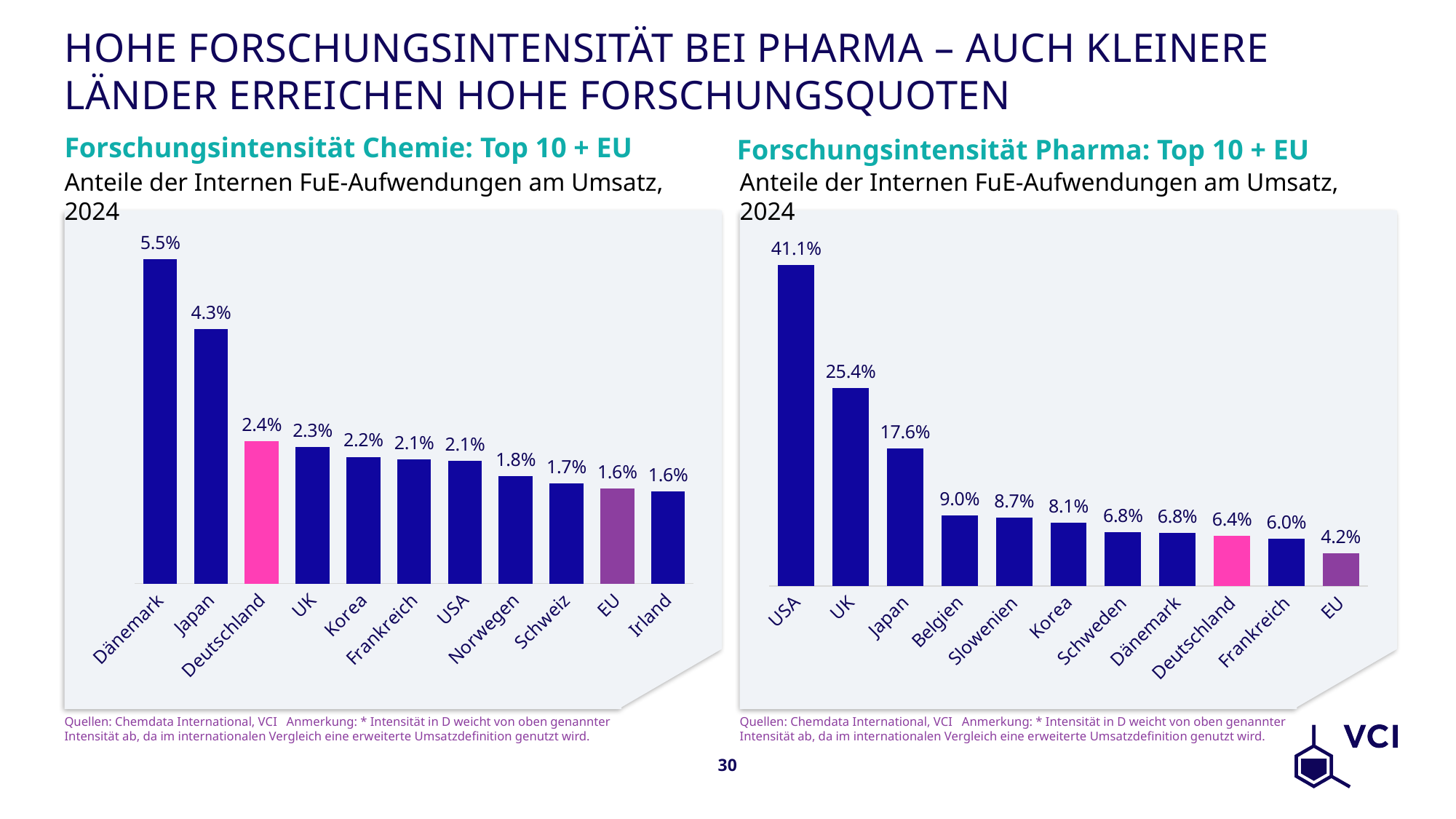
In the 'Forschungsintensität Chemie: Top 10 + EU' chart, what is the value for Japan? 4.3% What kind of chart is the 'Forschungsintensität Pharma: Top 10 + EU' chart? Bar chart In the 'Forschungsintensität Chemie: Top 10 + EU' chart, do the values rise or fall from left to right? Fall How many categories are shown in the 'Forschungsintensität Chemie: Top 10 + EU' chart? 11 In the 'Forschungsintensität Pharma: Top 10 + EU' chart, what is the value for Belgien? 9.0% How many categories are shown in the 'Forschungsintensität Pharma: Top 10 + EU' chart? 11 In the 'Forschungsintensität Pharma: Top 10 + EU' chart, which category has the lowest value? EU In the 'Forschungsintensität Pharma: Top 10 + EU' chart, which is larger, the value for Japan or the value for Korea? Japan In the 'Forschungsintensität Pharma: Top 10 + EU' chart, which bar is coloured pink? Deutschland In the 'Forschungsintensität Chemie: Top 10 + EU' chart, which country has the highest value? Dänemark In the 'Forschungsintensität Chemie: Top 10 + EU' chart, what is the difference between the values for Dänemark and Deutschland? 3.1% In the 'Forschungsintensität Pharma: Top 10 + EU' chart, what is the difference between the values for USA and UK? 15.7%